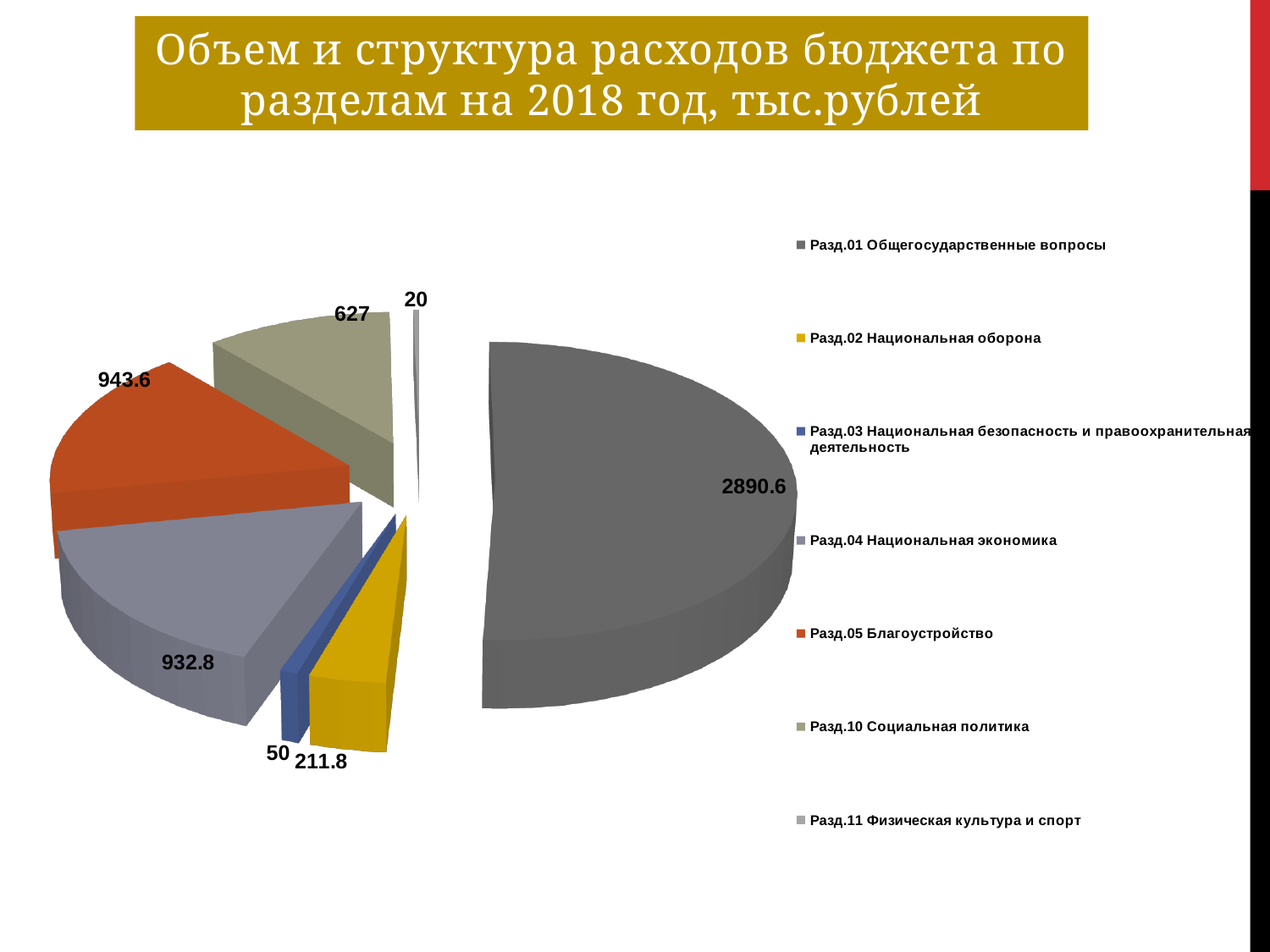
Which section has the largest slice of the pie? Разд.01 Общегосударственные вопросы What is the value for Разд.01 Общегосударственные вопросы? 2890.6 What is the value for Разд.11 Физическая культура и спорт? 20 What is the value for Разд.04 Национальная экономика? 932.8 What is the value for Разд.05 Благоустройство? 943.6 What is the difference between the values for Разд.02 Национальная оборона and Разд.03 Национальная безопасность и правоохранительная деятельность? 161.8 Which section has the smallest slice of the pie? Разд.11 Физическая культура и спорт Which is larger, the value for Разд.05 Благоустройство or the value for Разд.04 Национальная экономика? Разд.05 Благоустройство How many sections (slices) does the pie chart show? 7 What kind of chart is shown on the slide? pie chart What is the value for Разд.10 Социальная политика? 627 What is the difference between the values for Разд.01 Общегосударственные вопросы and Разд.05 Благоустройство? 1947